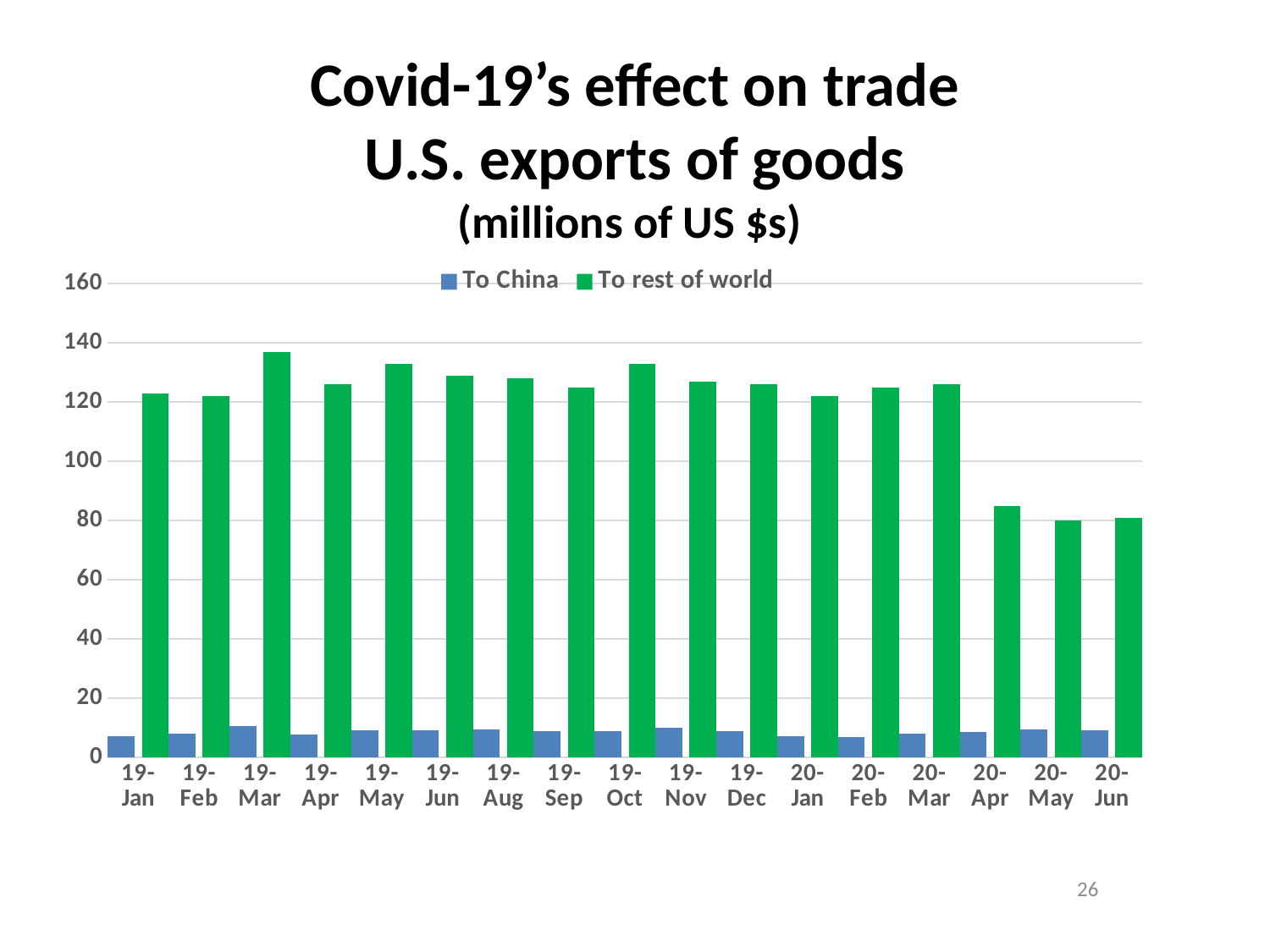
How many series does the legend list? 2 What kind of chart is shown on the slide? bar chart Which is larger for To rest of world: 19-Mar or 20-Apr? 19-Mar Is the value for To China in 19-Mar greater or less than 20? less What colour are the To China bars? blue How many months are shown along the x axis? 17 In 19-Jan, which series has the larger value: To China or To rest of world? To rest of world Do the To rest of world values rise or fall from 20-Mar to 20-Jun? fall Is the value for To rest of world in 19-Mar greater or less than 120? greater Which month has the highest value for To rest of world? 19-Mar Is the value for To rest of world in 20-Jun greater or less than 100? less